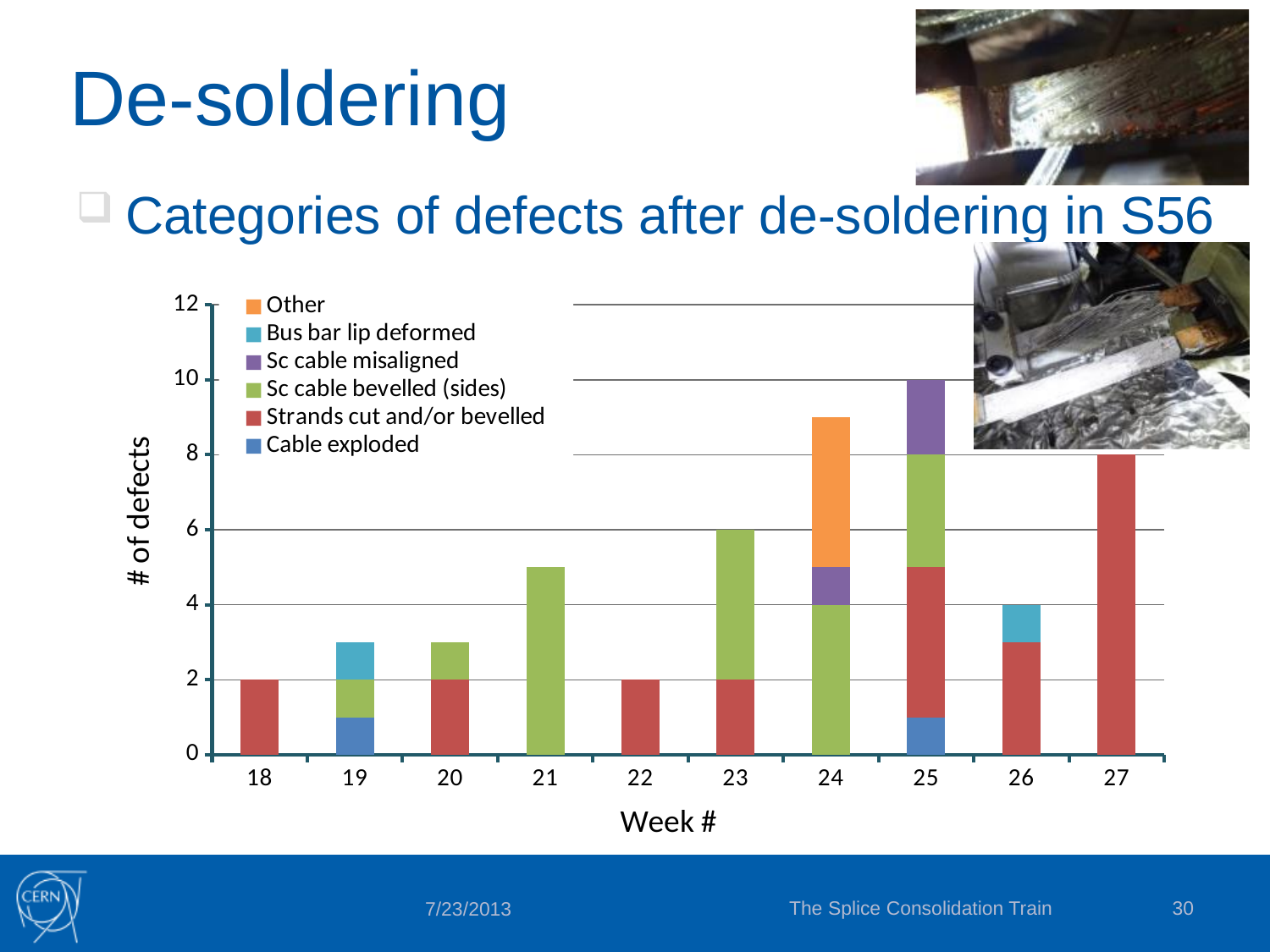
What is the difference between the total defects in week 25 and week 18? 8 What is the label of the x axis? Week # What is the total number of defects in week 27? 8 What is the total number of defects in week 18? 2 How many series does the legend list? 6 How many weeks are shown on the x axis? 10 Which has more total defects, week 27 or week 23? Week 27 What is the total number of defects in week 25? 10 What kind of chart is shown on the slide? Stacked bar chart Is the total number of defects in week 24 greater or less than 8? greater Is the total number of defects in week 19 greater or less than 4? less Which week has the highest total number of defects? 25